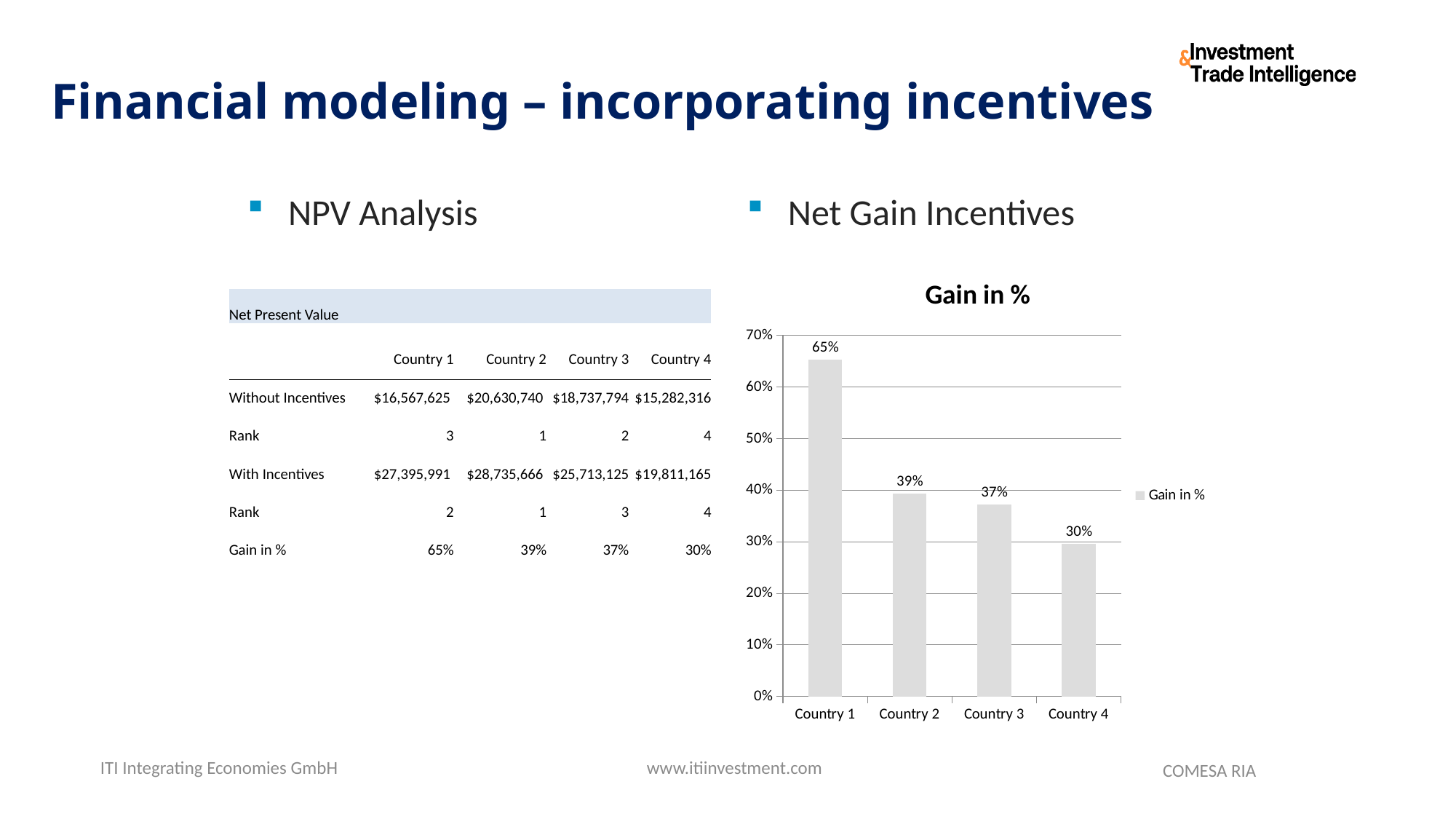
What is the value for Country 3 in the Gain in % chart? 37% Which country has the highest gain in the Gain in % chart? Country 1 How many countries are shown in the Gain in % chart? 4 Which country has the lowest gain in the Gain in % chart? Country 4 How many series does the legend of the Gain in % chart list? 1 What kind of chart is the Gain in % chart? bar chart What is the value for Country 4 in the Gain in % chart? 30% Is the value for Country 2 in the Gain in % chart greater or less than 40%? less In the Gain in % chart, which is larger: the value for Country 2 or Country 4? Country 2 What is the difference between the gain for Country 1 and Country 2 in the Gain in % chart? 26% What is the value for Country 1 in the Gain in % chart? 65% Do the values in the Gain in % chart rise or fall from Country 1 to Country 4? fall